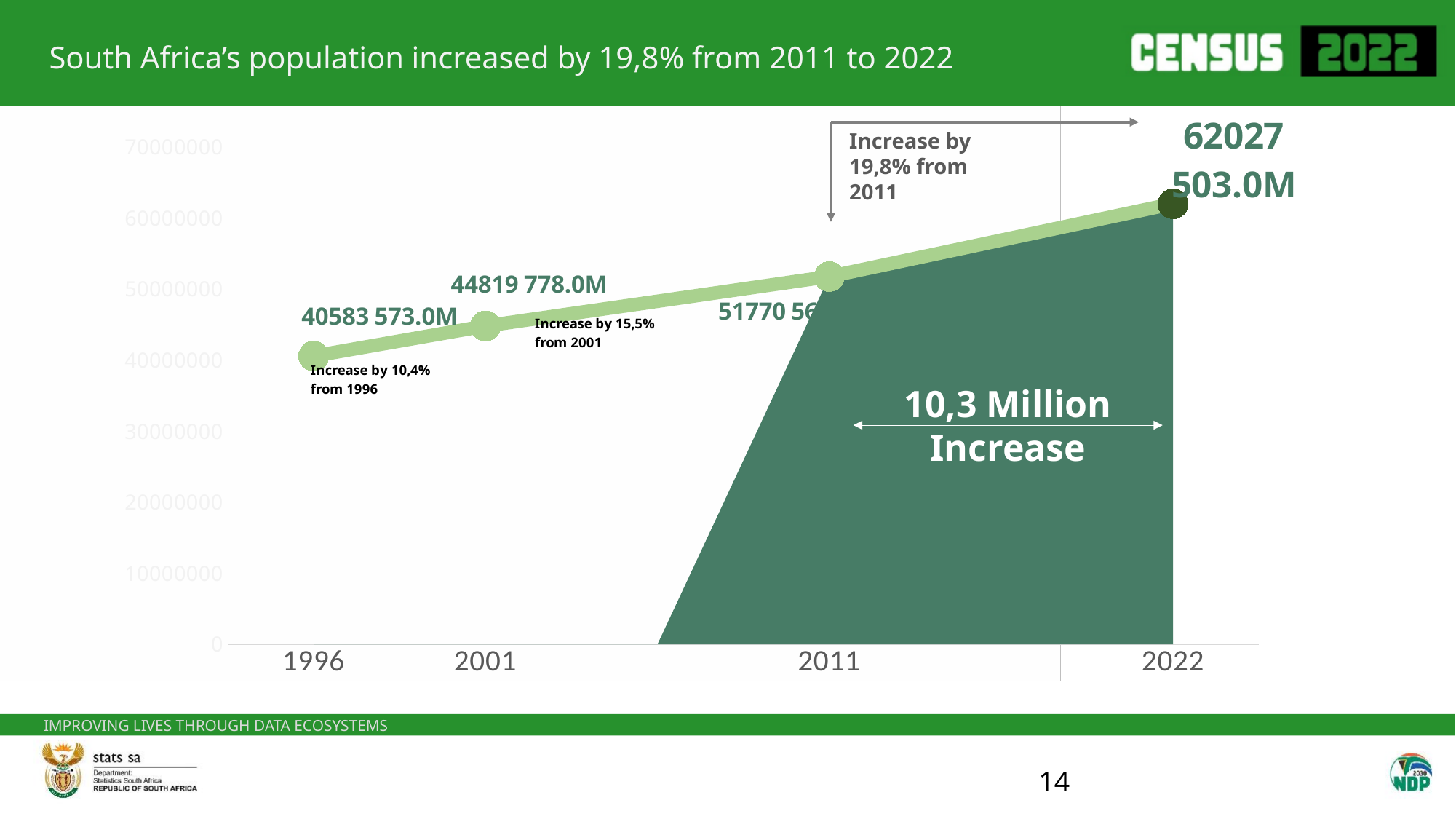
What is the population value shown for 2022? 62027 503.0M Is the value for 2022 greater or less than 60000000? greater What kind of chart is shown on the slide? combination line and area chart Is the value for 2011 greater or less than 60000000? less Which year has the highest population value on the chart? 2022 Is the value for 1996 greater or less than 50000000? less What is the population value shown for 2001? 44819 778.0M What is the population value shown for 1996? 40583 573.0M Do the population values rise or fall from 1996 to 2022? rise Which year has the larger population value, 1996 or 2001? 2001 How many years (data points) are plotted on the chart? 4 Which year has the lowest population value on the chart? 1996